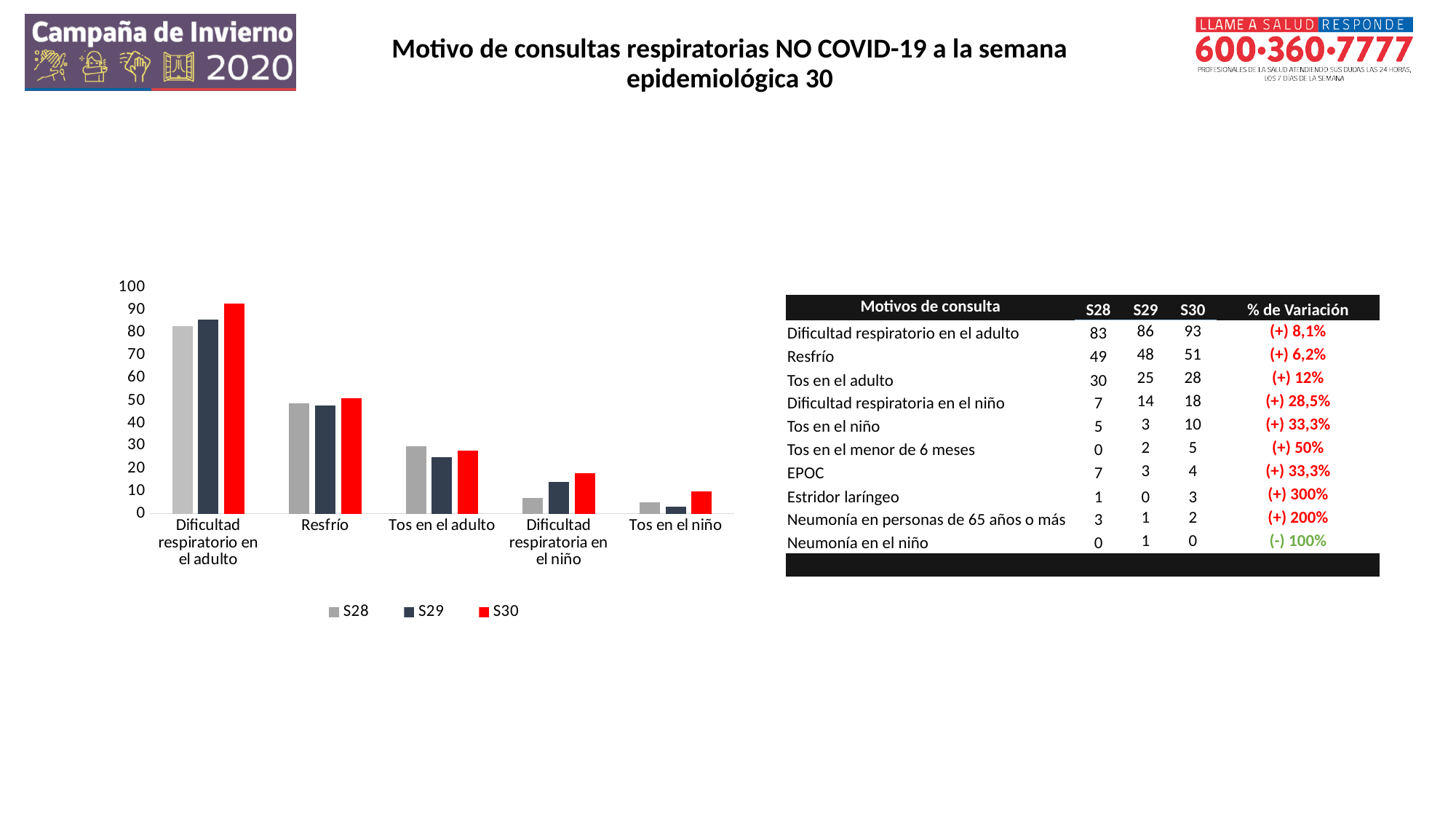
How many categories are shown on the x axis of the chart? 5 According to the slide, what is the S30 value for Resfrío? 51 Is the S29 value for Tos en el adulto greater or less than 30? less According to the slide, what is the S28 value for Dificultad respiratorio en el adulto? 83 Which category has the lowest S29 bar in the chart? Tos en el niño Which category has the highest S30 bar in the chart? Dificultad respiratorio en el adulto How many series does the chart legend list? 3 Which is larger for Dificultad respiratoria en el niño, the S28 bar or the S30 bar? S30 Is the S28 value for Resfrío greater or less than 50? less Is the S30 value for Dificultad respiratorio en el adulto greater or less than 90? greater What kind of chart is shown on the slide? bar chart What colour are the S30 bars in the chart? red